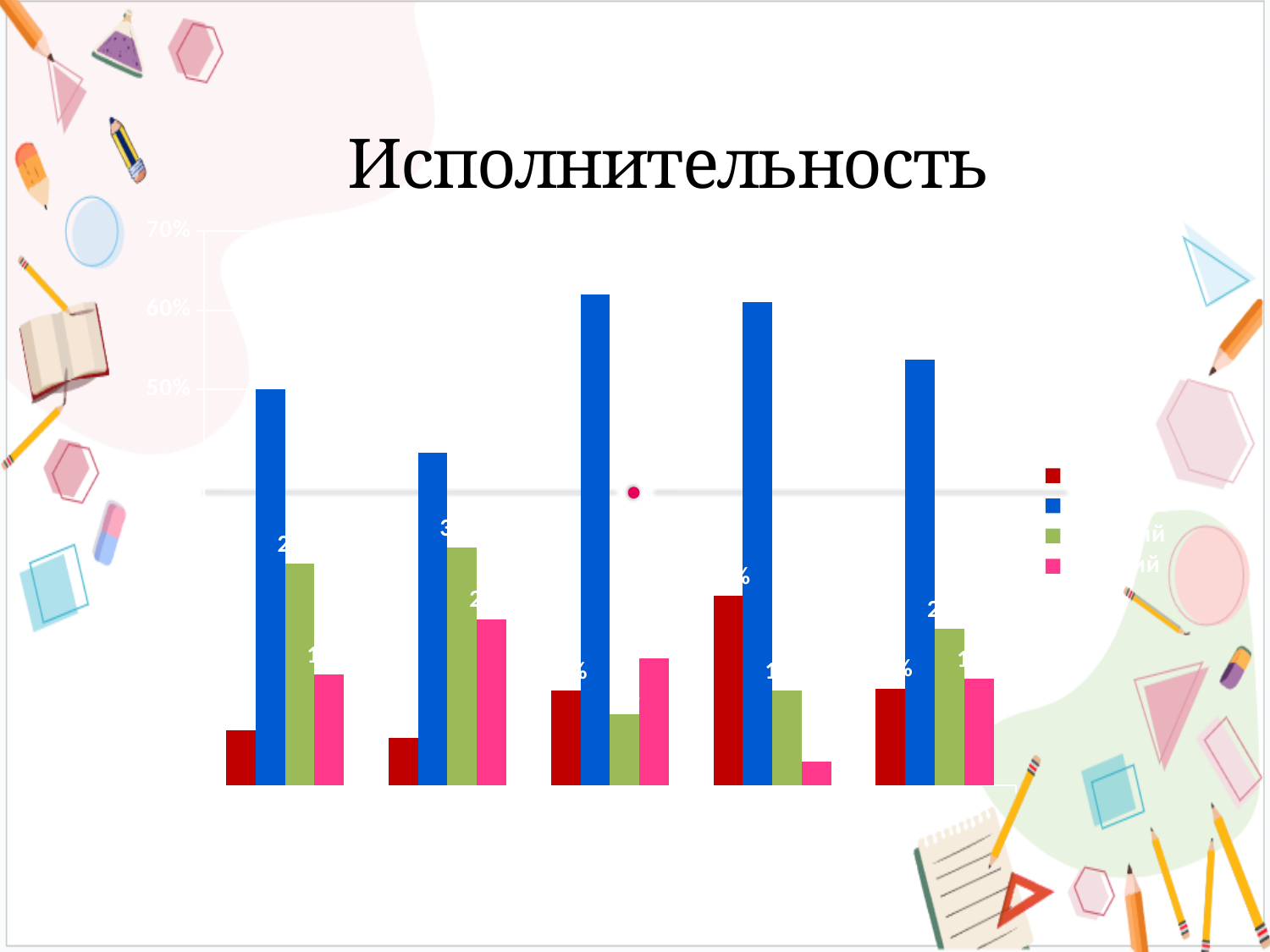
Is the blue bar in the fifth group from the left greater or less than 50%? greater Is the blue bar in the second group from the left greater or less than 50%? less Is the blue bar in the fifth group from the left greater or less than 60%? less How many series does the legend list? 4 In which group from the left does the blue bar reach its highest value? the third group How many groups of bars (categories) are plotted in the chart? 5 What is the title of the chart? Исполнительность Which colour of bar is the tallest in every group? blue In the fourth group from the left, which is taller: the dark red bar or the green bar? the dark red bar In the first group from the left, which is taller: the green bar or the pink bar? the green bar What kind of chart is shown on the slide? bar chart